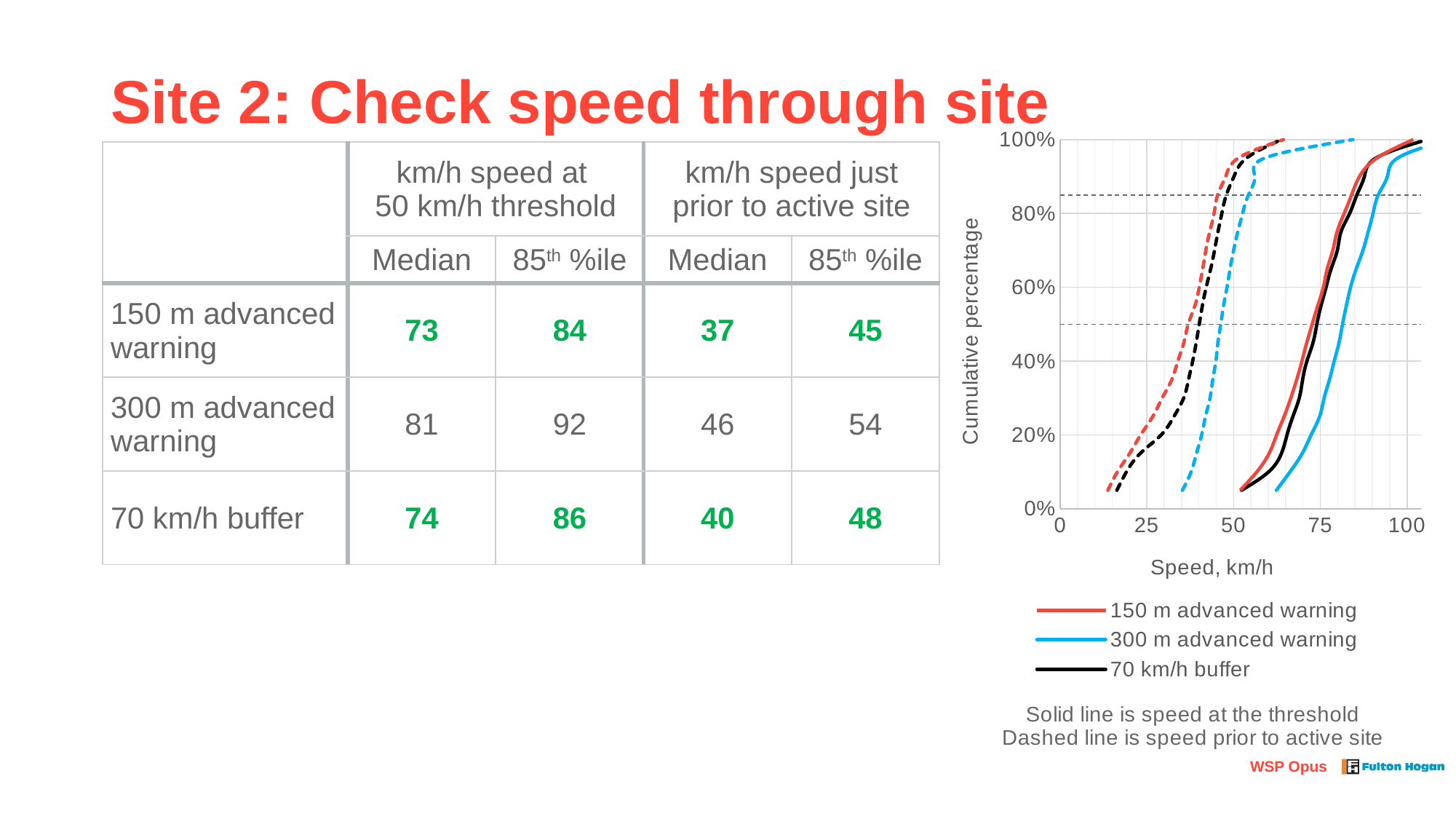
At 100 km/h, is the solid 300 m advanced warning line greater or less than 80%? greater At 50 km/h, which dashed line is higher: 150 m advanced warning or 300 m advanced warning? 150 m advanced warning At 25 km/h, is the dashed 150 m advanced warning line greater or less than 40%? less Which series' solid line reaches 50% cumulative percentage at the highest speed? 300 m advanced warning What are the three series named in the chart legend? 150 m advanced warning, 300 m advanced warning, 70 km/h buffer Which series' dashed line lies furthest to the right on the chart? 300 m advanced warning At 75 km/h, is the solid 150 m advanced warning line greater or less than 40%? greater What is the label of the chart's x axis? Speed, km/h How many series does the chart legend list? 3 Do the lines in the chart rise or fall as speed increases along the x axis? rise What kind of chart is shown on the right of the slide? line chart